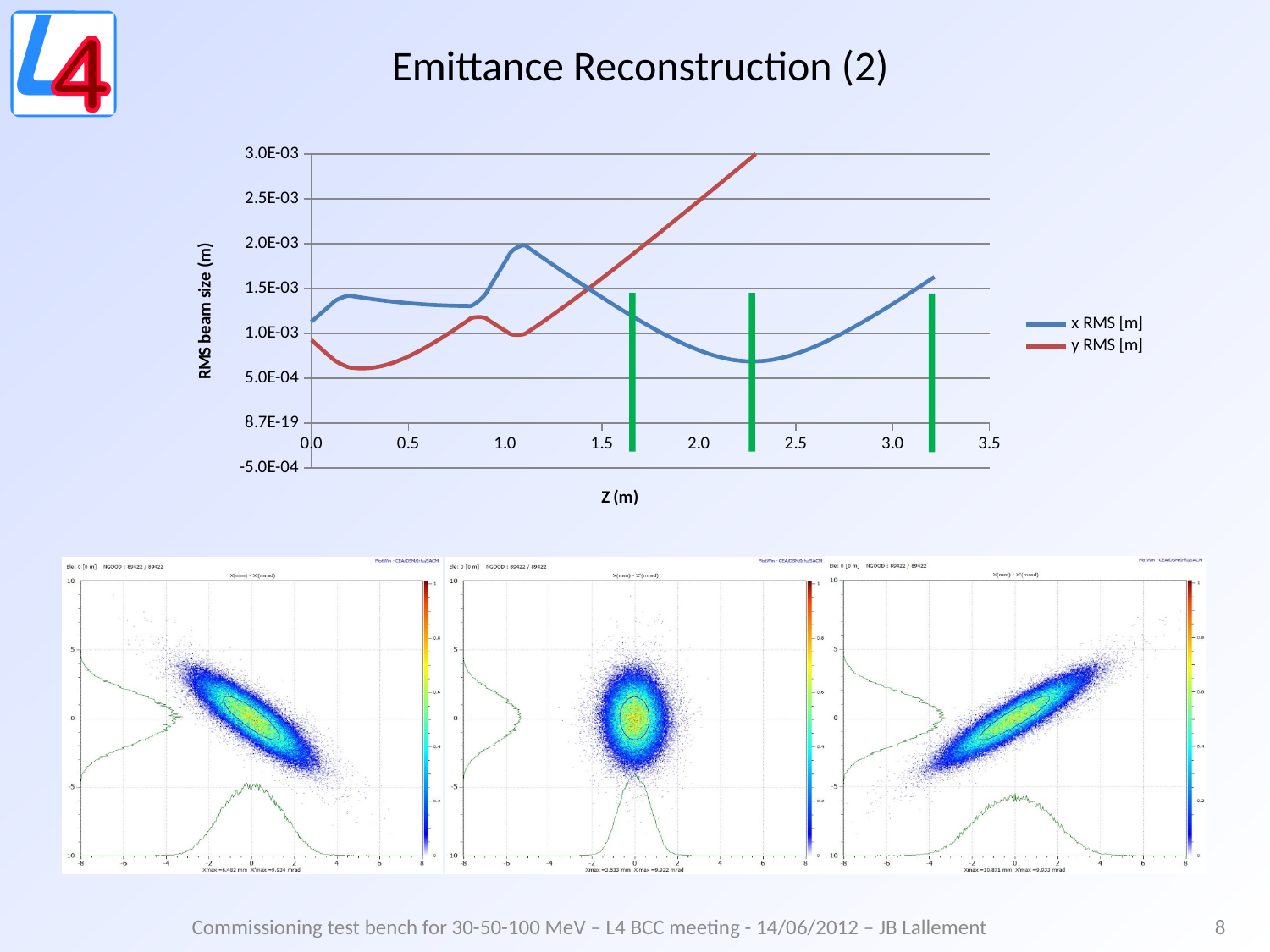
In the top chart, is the value of x RMS [m] at Z = 2.0 greater or less than 1.0E-03? less What is the x-axis title of the top chart? Z (m) In the top chart, which series has the larger value at Z = 0.5, x RMS [m] or y RMS [m]? x RMS [m] How many phase-space scatter plots are shown in the bottom row of the slide? 3 In the top chart, is the value of y RMS [m] at Z = 2.0 greater or less than 1.5E-03? greater How many series does the legend of the top chart list? 2 In the top chart, which series has the larger value at Z = 2.0, x RMS [m] or y RMS [m]? y RMS [m] What are the two series named in the legend of the top chart? x RMS [m] and y RMS [m] In the top chart, is the value of y RMS [m] at Z = 0.5 greater or less than 1.0E-03? less What kind of chart is the top chart on the slide? line chart In the top chart, does the y RMS [m] series rise or fall between Z = 1.5 and Z = 3.0? rise